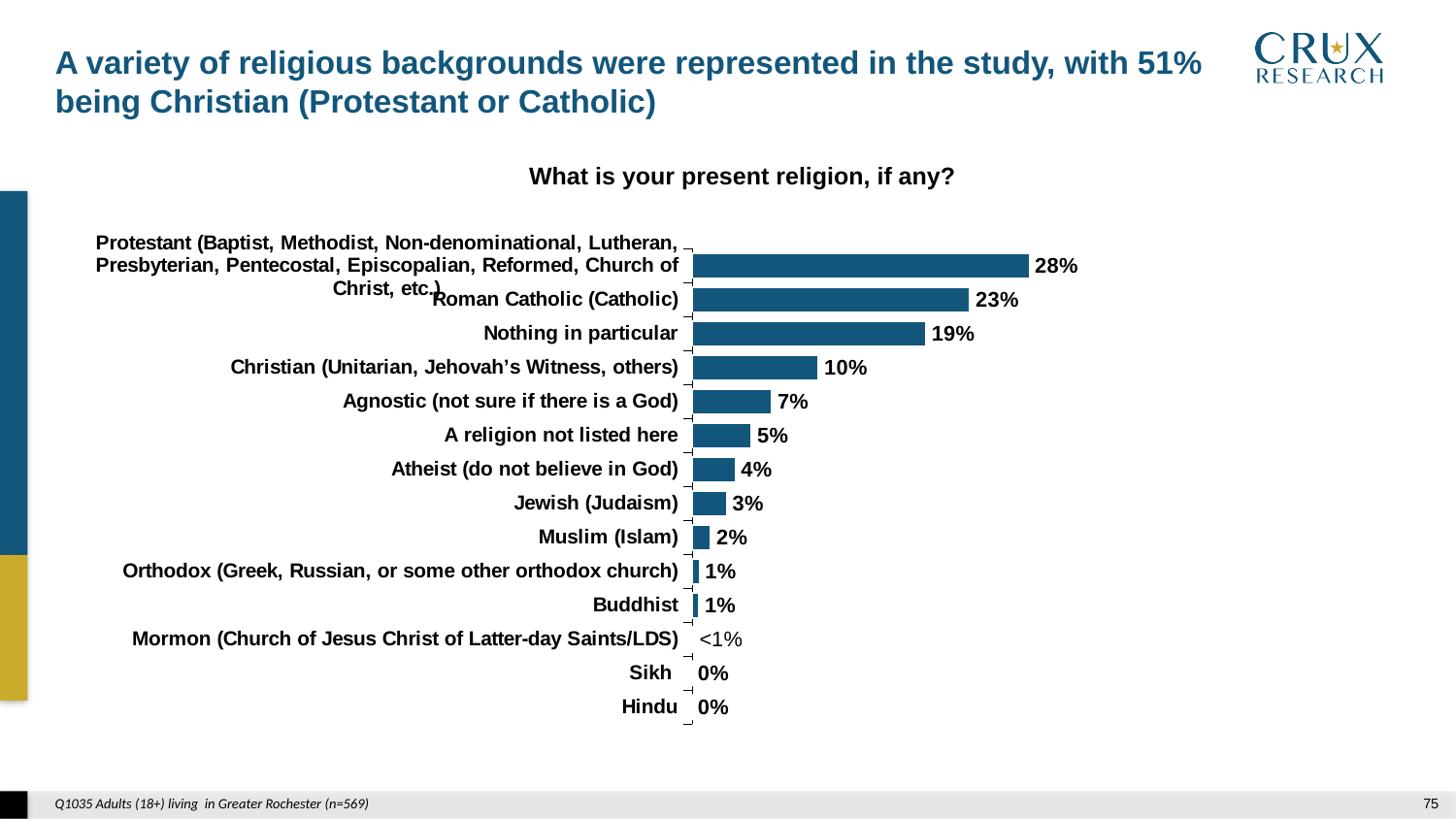
What value is shown for Mormon (Church of Jesus Christ of Latter-day Saints/LDS)? <1% What is the difference in percentage points between the Protestant bar and the Roman Catholic (Catholic) bar? 5 Which religion category has the highest percentage in the chart? Protestant (Baptist, Methodist, Non-denominational, Lutheran, Presbyterian, Pentecostal, Episcopalian, Reformed, Church of Christ, etc.) What is the value shown for "Nothing in particular"? 19% What type of chart is shown on the slide? Bar chart What percentage of respondents said their present religion is Roman Catholic (Catholic)? 23% What percentage is shown for Agnostic (not sure if there is a God)? 7% What question is the chart based on, as shown in its title? What is your present religion, if any? What is the difference between the values for Atheist (do not believe in God) and Jewish (Judaism)? 1% What is the combined percentage of the Protestant and Roman Catholic (Catholic) bars? 51% Which is larger, the value for Christian (Unitarian, Jehovah's Witness, others) or the value for A religion not listed here? Christian (Unitarian, Jehovah's Witness, others) How many religion categories are shown in the chart? 14